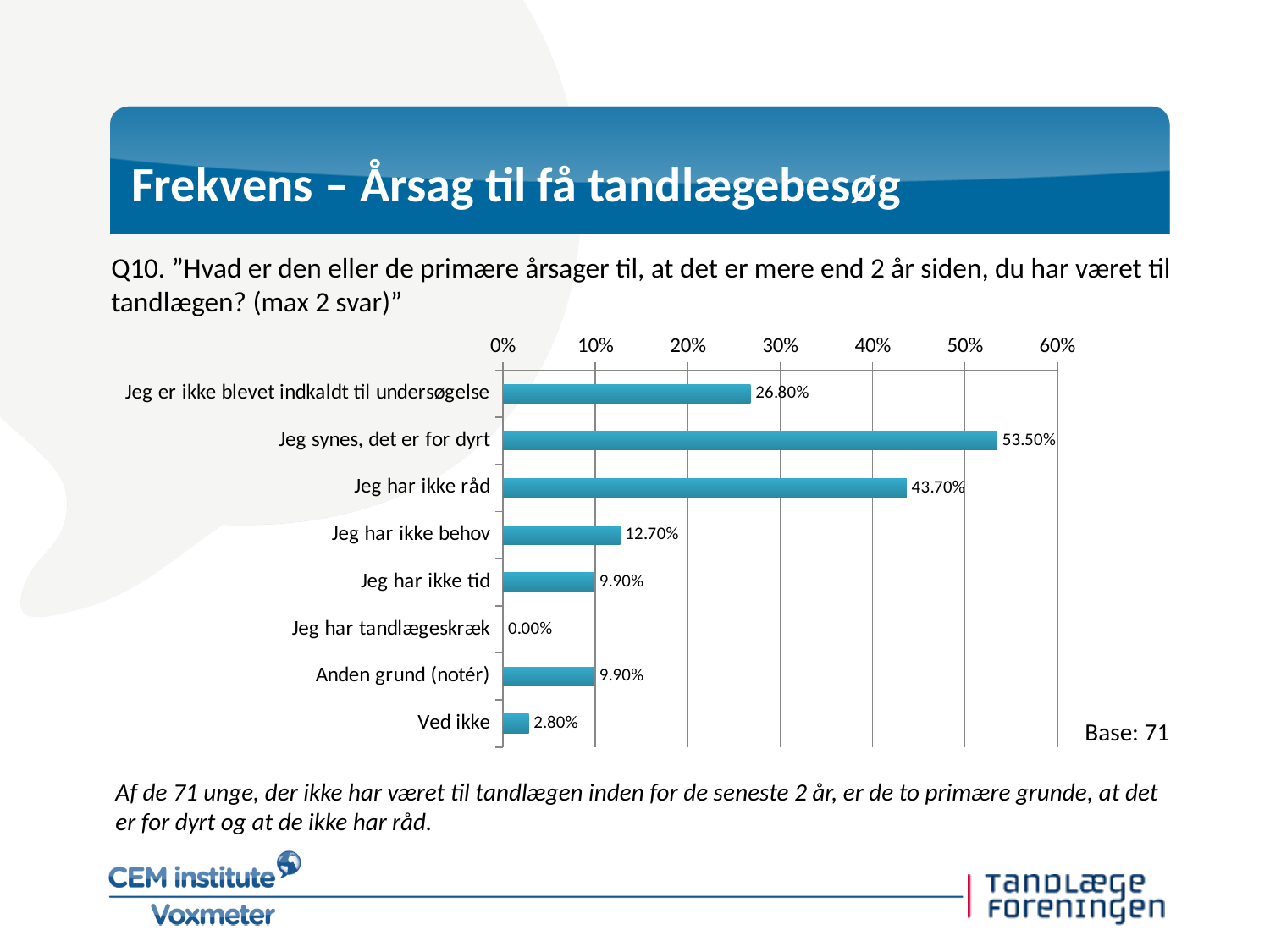
Which category has the highest value? Jeg synes, det er for dyrt What kind of chart is shown on the slide? Bar chart Is the value for "Jeg har ikke råd" greater or less than 40%? greater What is the base (number of respondents) shown next to the chart? 71 How many categories are shown in the chart? 8 Which category has the lowest value? Jeg har tandlægeskræk What is the value for "Ved ikke"? 2.80% What is the value for "Jeg synes, det er for dyrt"? 53.50% Which is larger, "Jeg har ikke behov" or "Jeg har ikke tid"? Jeg har ikke behov What is the difference between "Jeg synes, det er for dyrt" and "Jeg har ikke råd"? 9.80% What is the value for "Jeg er ikke blevet indkaldt til undersøgelse"? 26.80% What is the value for "Jeg har tandlægeskræk"? 0.00%